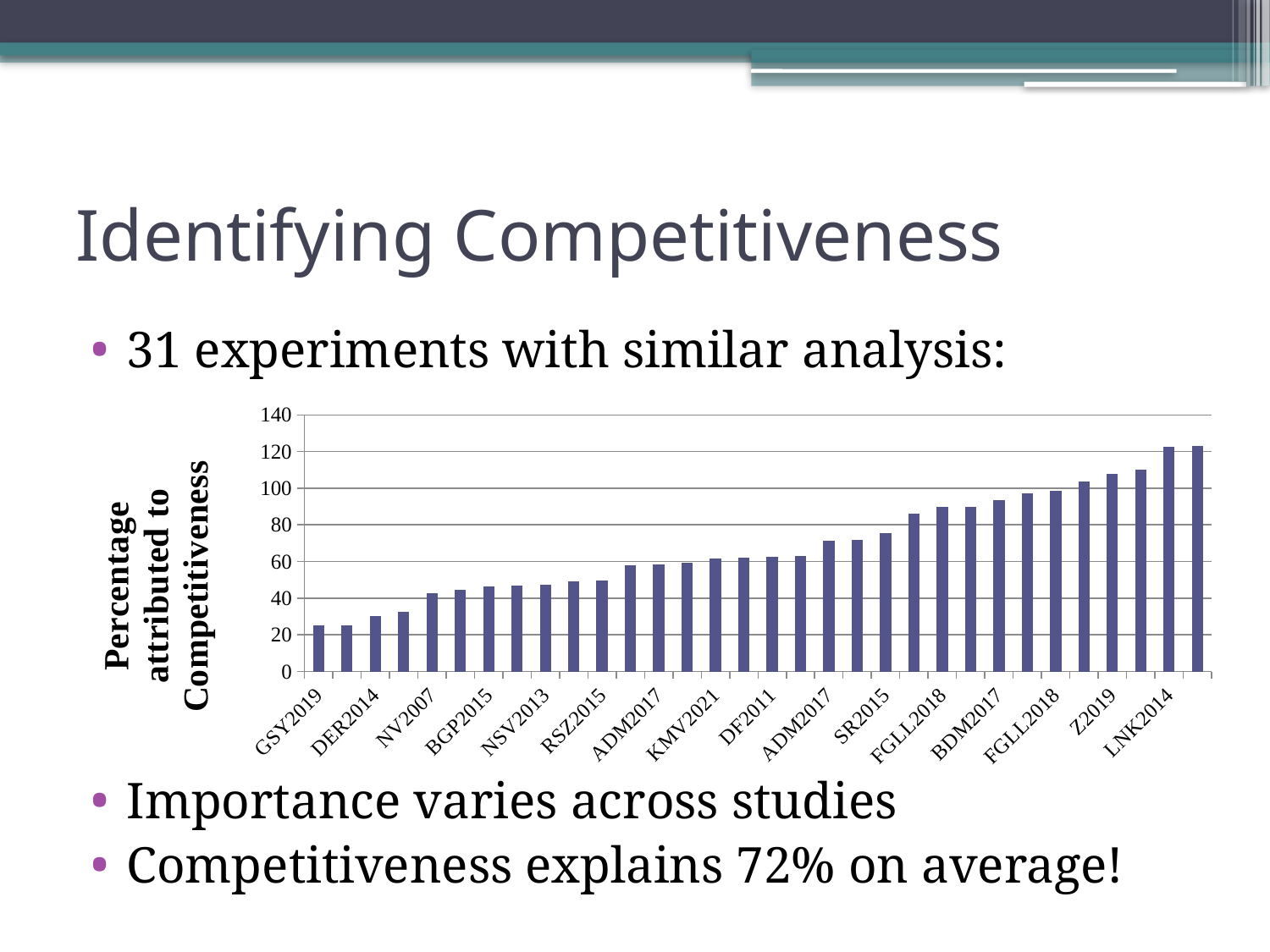
What kind of chart is shown on the slide? bar chart Is the value for KMV2021 greater or less than 80? less Is the value for GSY2019 greater or less than 40? less Is the value for BDM2017 greater or less than 80? greater What is the title of the vertical axis of the chart? Percentage attributed to Competitiveness Do the bar values rise or fall from left to right along the x axis? rise Which has the larger value, LNK2014 or GSY2019? LNK2014 How many bars (experiments) are plotted in the chart? 32